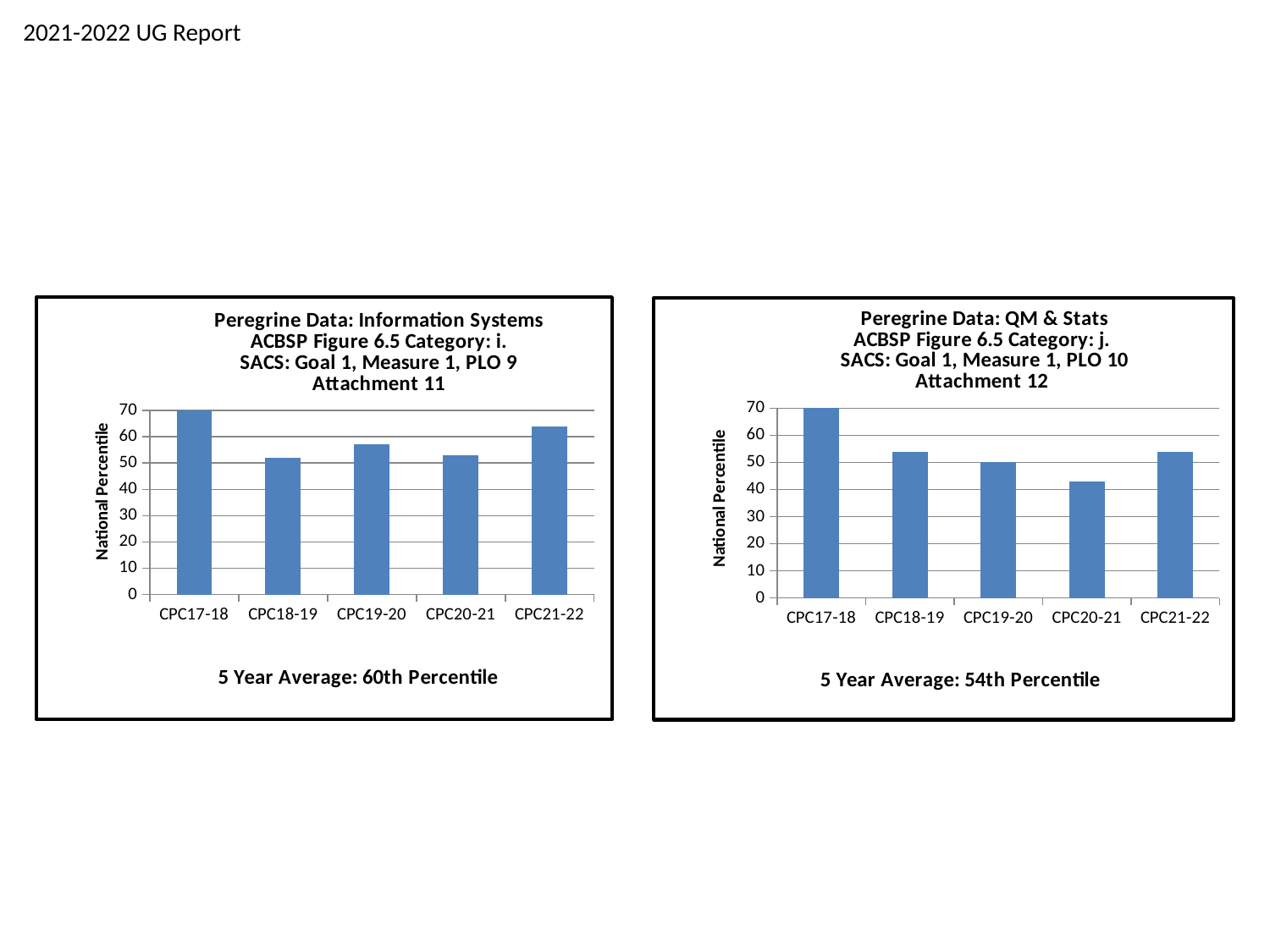
In the Peregrine Data: Information Systems chart, is the value for CPC21-22 greater or less than 60? greater In the Peregrine Data: Information Systems chart, which is larger, the value for CPC21-22 or CPC18-19? CPC21-22 In the Peregrine Data: QM & Stats chart, which year has the lowest national percentile? CPC20-21 What 5 year average is stated below the Peregrine Data: QM & Stats chart? 54th Percentile In the Peregrine Data: QM & Stats chart, is the value for CPC20-21 greater or less than 50? less How many years are shown in the Peregrine Data: QM & Stats chart? 5 In the Peregrine Data: Information Systems chart, which year has the highest national percentile? CPC17-18 In the Peregrine Data: QM & Stats chart, which year has the highest national percentile? CPC17-18 In the Peregrine Data: Information Systems chart, is the value for CPC19-20 greater or less than 50? greater What kind of chart is the Peregrine Data: Information Systems chart? Bar chart In the Peregrine Data: QM & Stats chart, what is the national percentile for CPC19-20? 50